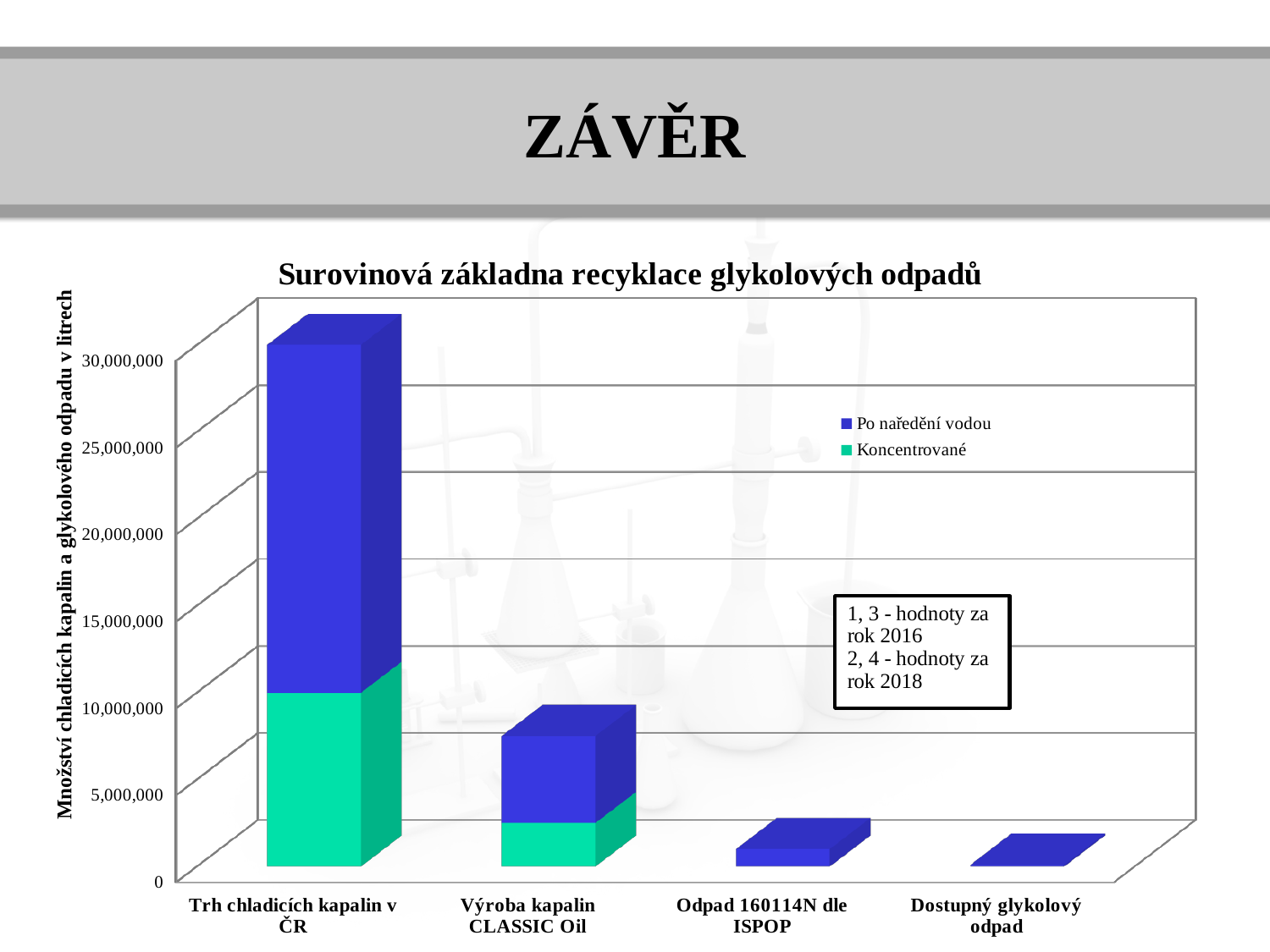
How many series does the legend list? 2 Which is larger, the total bar for Výroba kapalin CLASSIC Oil or for Odpad 160114N dle ISPOP? Výroba kapalin CLASSIC Oil Is the total value for Trh chladicích kapalin v ČR greater or less than 25,000,000? greater What kind of chart is shown on the slide? Stacked bar chart Which legend entry is shown in green? Koncentrované Is the total value for Výroba kapalin CLASSIC Oil greater or less than 10,000,000? less Is the value for Odpad 160114N dle ISPOP greater or less than 5,000,000? less Which category has the shortest stacked bar? Dostupný glykolový odpad Which category has the tallest stacked bar? Trh chladicích kapalin v ČR How many categories are shown on the x axis? 4 What is the title of the chart? Surovinová základna recyklace glykolových odpadů